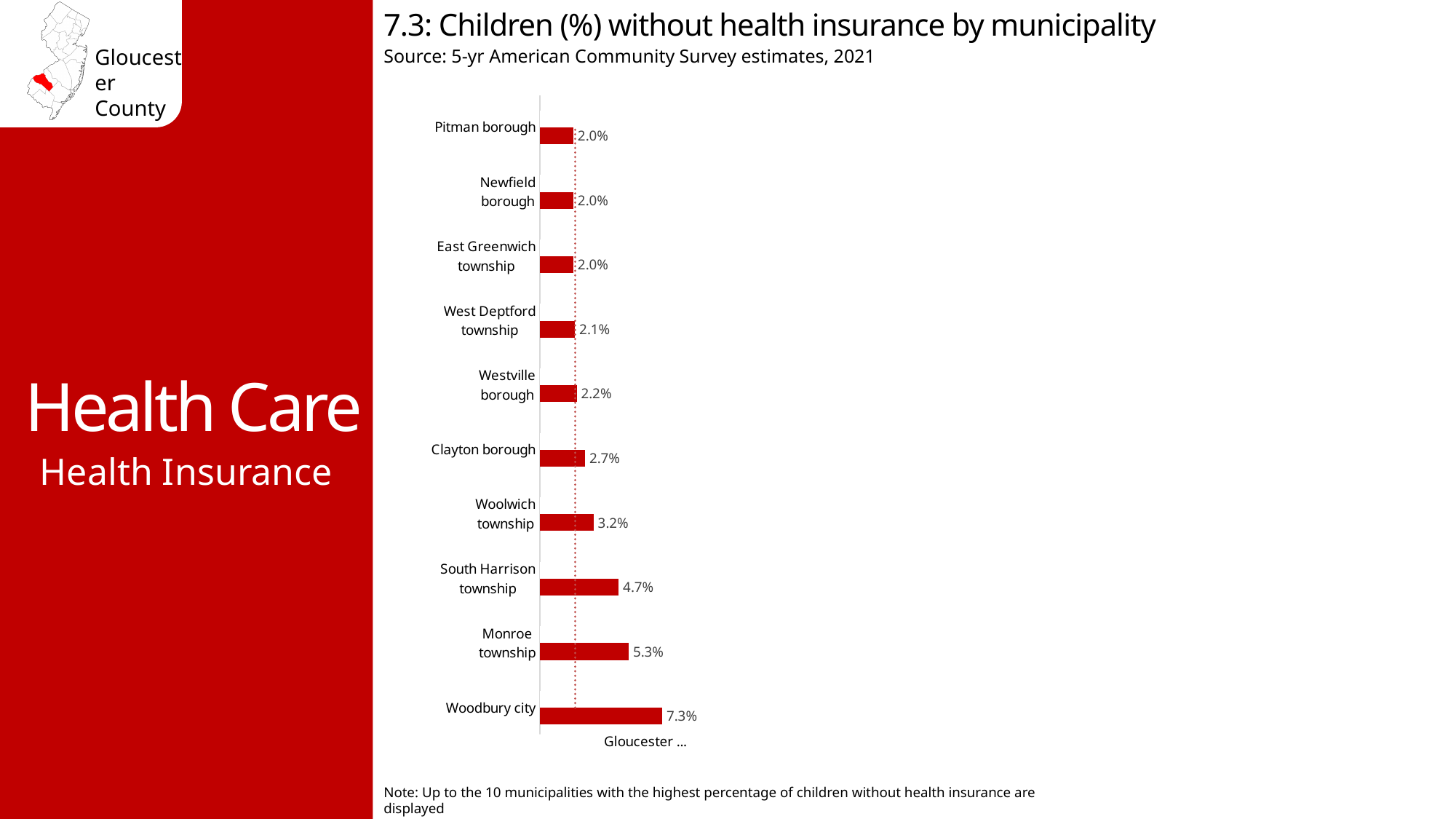
What kind of chart is shown on the slide? Bar chart What is the difference between the values for South Harrison township and Woolwich township? 1.5% What is the difference between the values for Woodbury city and Monroe township? 2.0% Which has a higher value, Monroe township or Westville borough? Monroe township What is the value shown for Clayton borough? 2.7% Which has a higher value, South Harrison township or Clayton borough? South Harrison township What is the percentage of children without health insurance in Woodbury city? 7.3% What is the title of the chart? 7.3: Children (%) without health insurance by municipality Which municipality has the highest percentage of children without health insurance? Woodbury city What is the value shown for Woolwich township? 3.2% What is the value shown for Monroe township? 5.3% How many municipalities are shown in the chart? 10